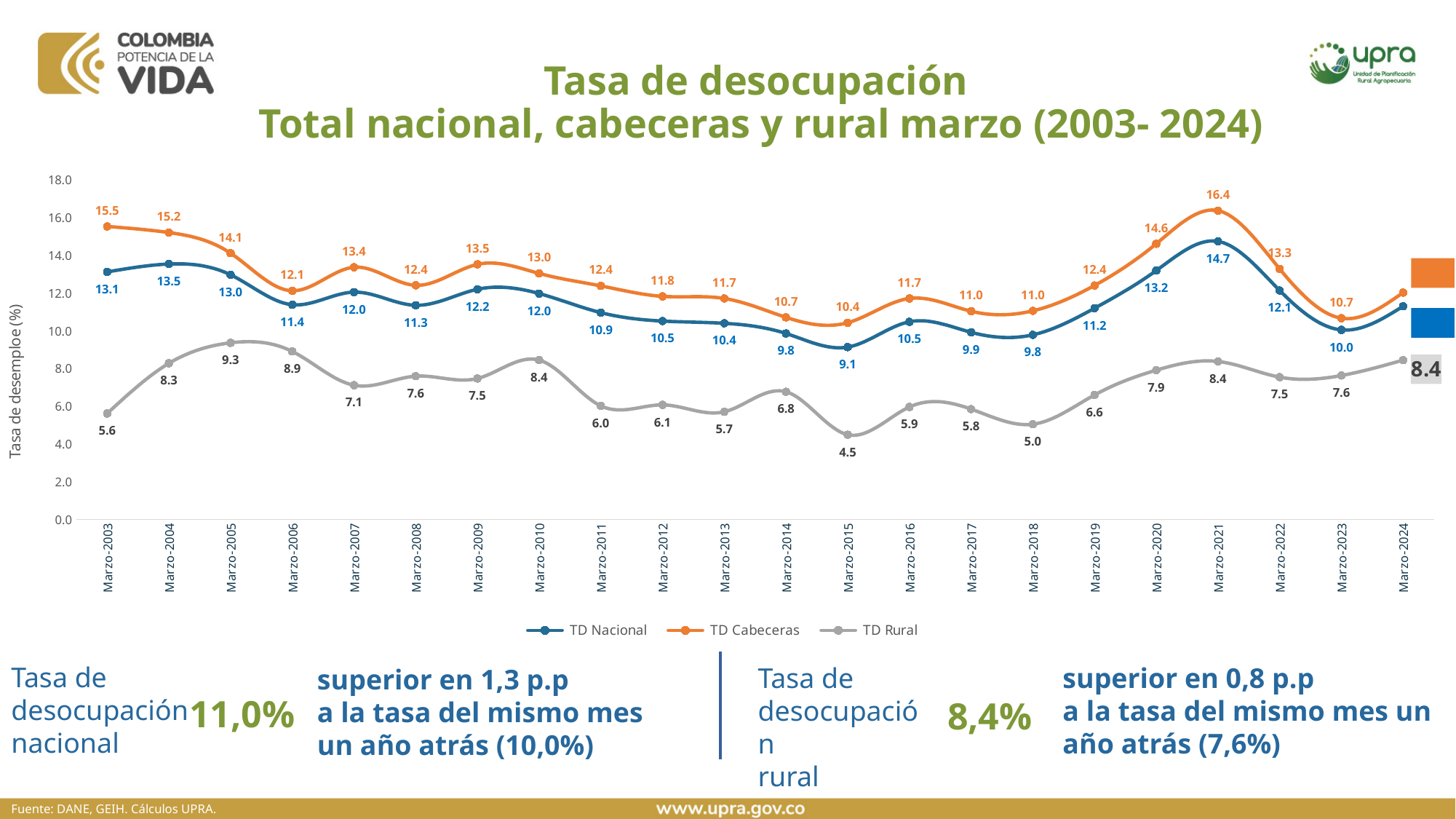
What is the difference between TD Cabeceras and TD Nacional in Marzo-2021? 1.7 What kind of chart is shown on the slide? line chart What is the value of TD Nacional in Marzo-2015? 9.1 In which period does TD Cabeceras reach its highest value? Marzo-2021 How many series does the legend list? 3 Is the value of TD Nacional in Marzo-2024 greater or less than 10.0? greater Which is larger for TD Rural: the value in Marzo-2005 or in Marzo-2020? Marzo-2005 Does TD Nacional rise or fall from Marzo-2021 to Marzo-2023? fall What is the value of TD Cabeceras in Marzo-2021? 16.4 In which period does TD Rural reach its lowest value? Marzo-2015 What is the value of TD Rural in Marzo-2003? 5.6 How many periods are shown on the x axis? 22